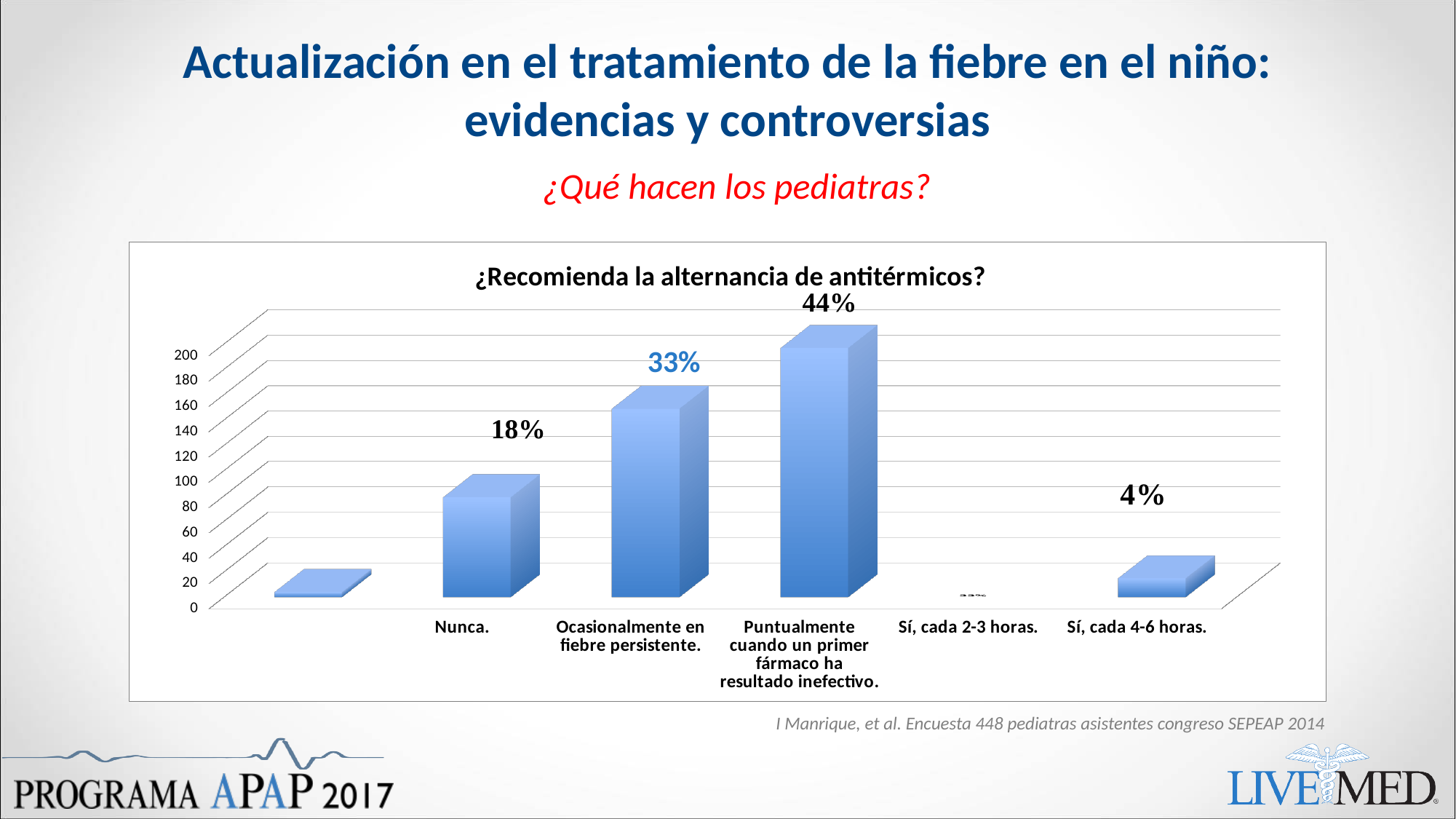
What is the difference in percentage points between the labels for 'Puntualmente cuando un primer fármaco ha resultado inefectivo.' and 'Ocasionalmente en fiebre persistente.'? 11% Which labelled category has the highest bar? Puntualmente cuando un primer fármaco ha resultado inefectivo. What kind of chart is shown on the slide? bar chart Is the bar for 'Puntualmente cuando un primer fármaco ha resultado inefectivo.' greater or less than 140 on the vertical axis? greater What is the data label shown for 'Ocasionalmente en fiebre persistente.'? 33% What is the data label shown for 'Puntualmente cuando un primer fármaco ha resultado inefectivo.'? 44% Which is larger, the bar for 'Nunca.' or the bar for 'Ocasionalmente en fiebre persistente.'? Ocasionalmente en fiebre persistente. Is the bar for 'Nunca.' greater or less than 120 on the vertical axis? less What is the data label shown for the 'Nunca.' category? 18% Which labelled category has the lowest bar? Sí, cada 2-3 horas. What is the title of the chart? ¿Recomienda la alternancia de antitérmicos? What is the data label shown for 'Sí, cada 4-6 horas.'? 4%